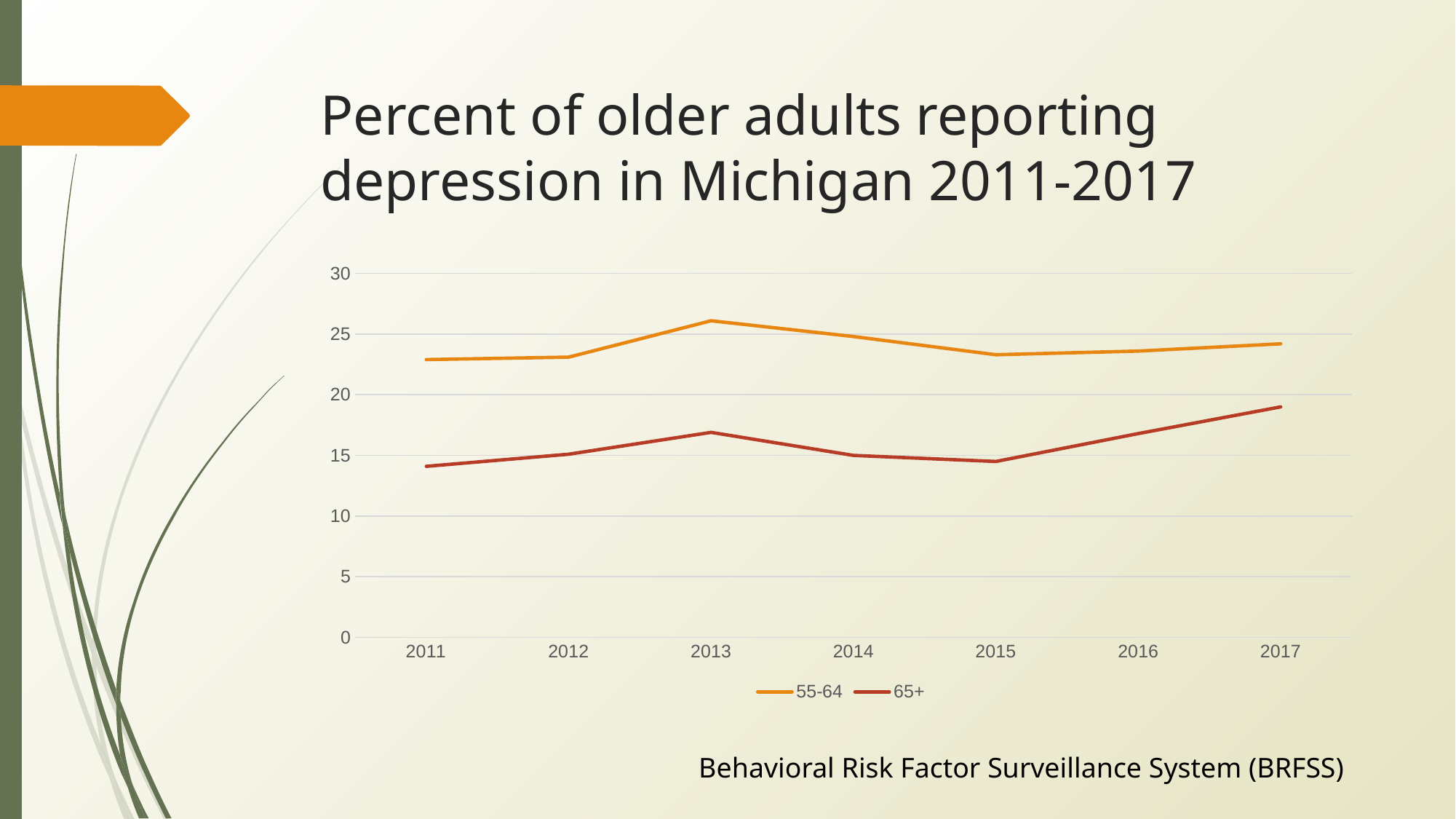
Is the value for the 65+ series in 2017 greater or less than 20? less How many years are plotted along the x axis? 7 What kind of chart is shown on the slide? line chart In which year does the 55-64 series reach its highest value? 2013 Is the value for the 55-64 series in 2015 greater or less than 25? less Is the value for the 55-64 series in 2013 greater or less than 25? greater In which year does the 65+ series reach its highest value? 2017 How many series does the legend list? 2 Does the 65+ series rise or fall from 2015 to 2017? rise Which series has the larger value in 2013, 55-64 or 65+? 55-64 What is the title of the chart on the slide? Percent of older adults reporting depression in Michigan 2011-2017